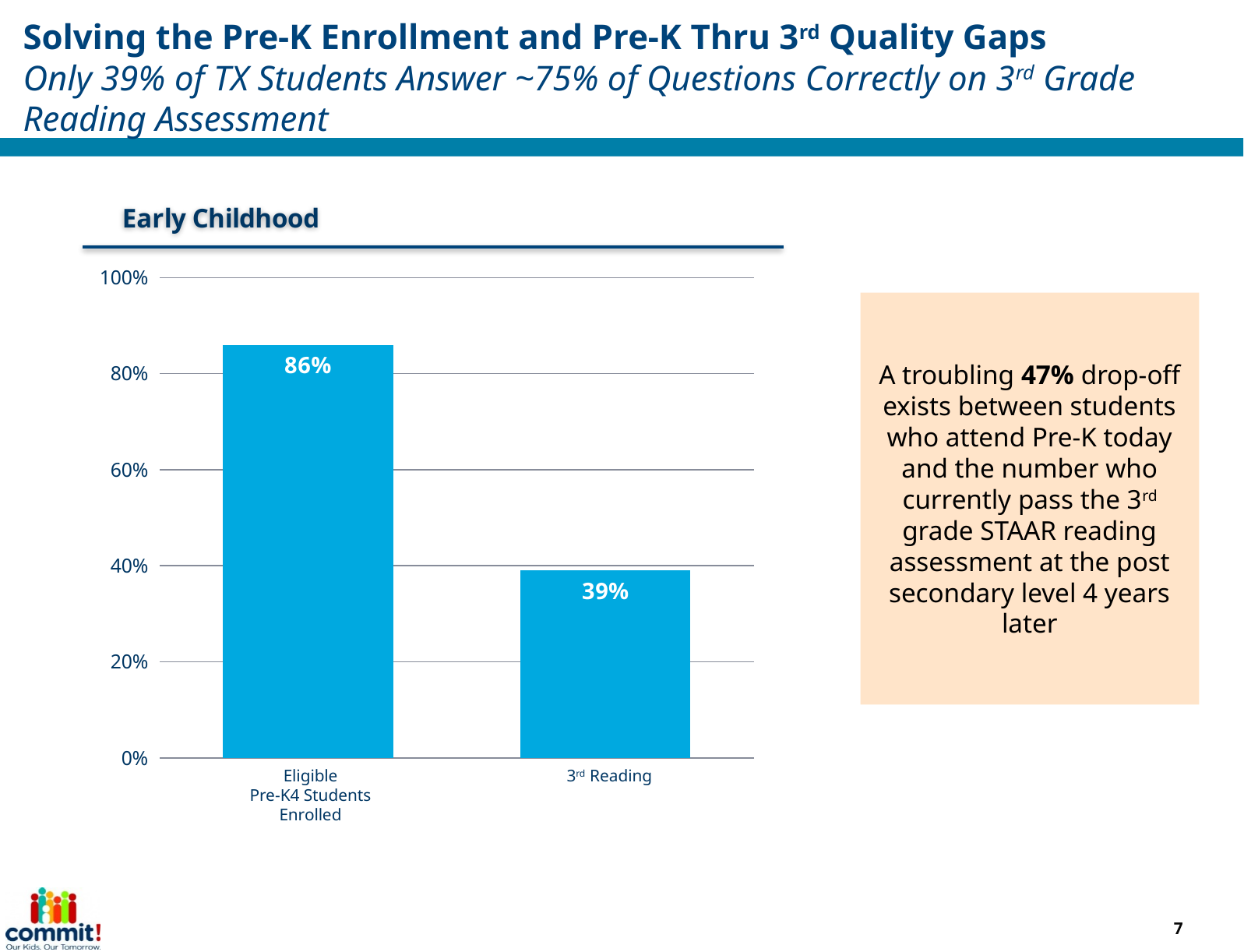
Which category has the lowest value? 3rd Reading What kind of chart is shown on the slide? Bar chart Which category has the highest value? Eligible Pre-K4 Students Enrolled What is the title of the chart? Early Childhood Which is larger, the value for Eligible Pre-K4 Students Enrolled or the value for 3rd Reading? Eligible Pre-K4 Students Enrolled Is the value for Eligible Pre-K4 Students Enrolled greater or less than 80%? greater What is the value for 3rd Reading? 39% Do the values rise or fall from left to right across the categories? Fall How many categories are shown in the chart? 2 Is the value for 3rd Reading greater or less than 40%? less What is the value for Eligible Pre-K4 Students Enrolled? 86% What is the difference between the value for Eligible Pre-K4 Students Enrolled and the value for 3rd Reading? 47%